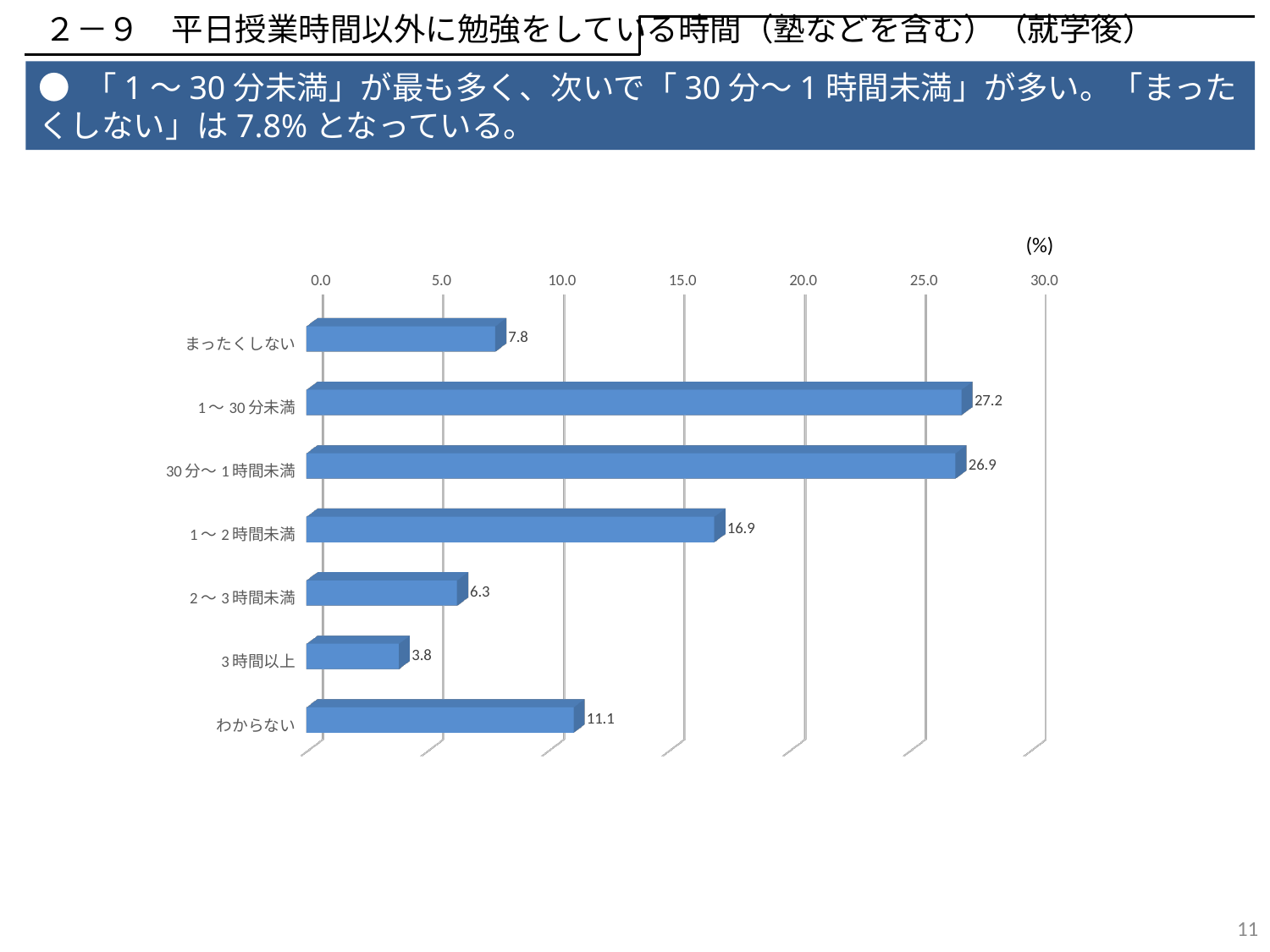
Which category has the lowest value? 3時間以上 Is the value for 30分～1時間未満 greater or less than 25.0? greater What is the value for わからない? 11.1 Which is larger, the value for まったくしない or the value for わからない? わからない How many categories are shown in the chart? 7 What is the value for まったくしない? 7.8 What unit is indicated above the axis of the chart? (%) What kind of chart is shown on the slide? bar chart Which category has the highest value? 1～30分未満 What is the difference between the values for 1～2時間未満 and 2～3時間未満? 10.6 What is the value for 1～30分未満? 27.2 What is the value for 3時間以上? 3.8